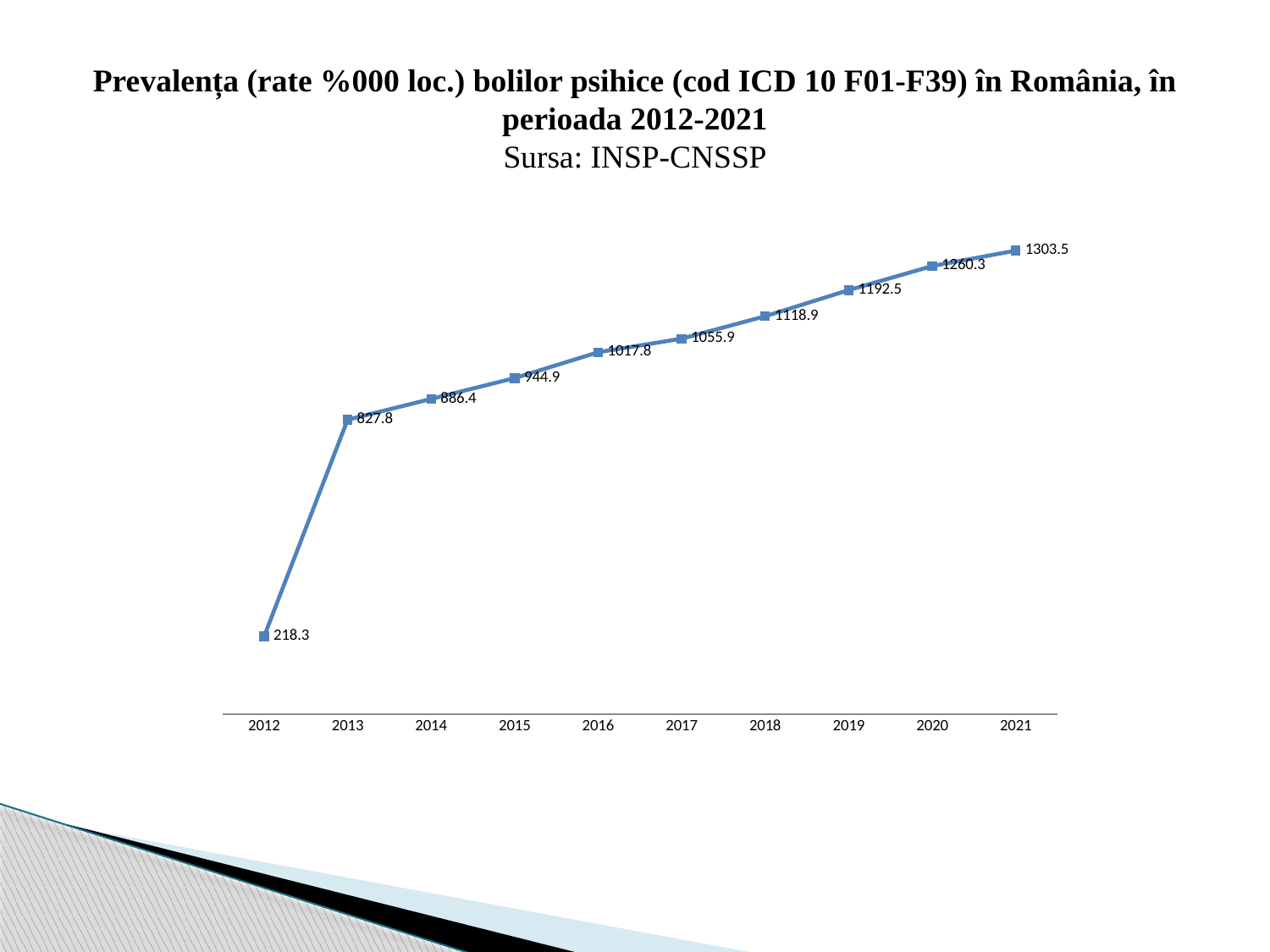
What is the prevalence rate for 2012? 218.3 What kind of chart is shown on the slide? Line chart Which year has a higher prevalence rate, 2015 or 2018? 2018 Which year has the lowest prevalence rate? 2012 What is the prevalence rate for 2017? 1055.9 What is the prevalence rate for 2021? 1303.5 Which year has the highest prevalence rate? 2021 What is the difference between the prevalence rates for 2013 and 2012? 609.5 What source is cited for the chart data? INSP-CNSSP What is the difference between the prevalence rates for 2021 and 2020? 43.2 Do the prevalence rates rise or fall from 2012 to 2021? Rise How many years are plotted on the chart? 10